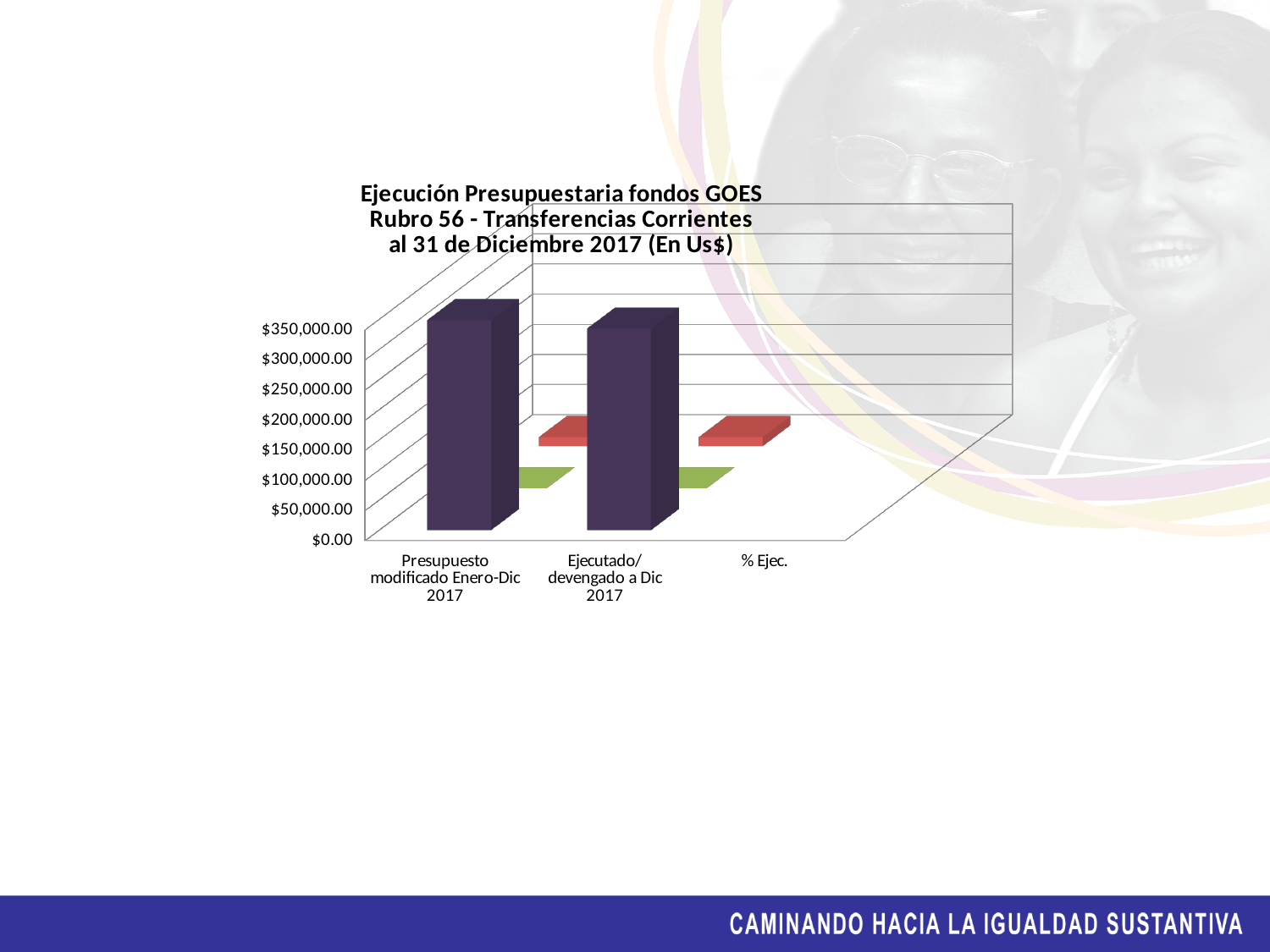
What kind of chart is shown on the slide? bar chart What is the label of the third category on the x axis? % Ejec. How many categories are shown on the x axis of the chart? 3 Which category on the x axis shows the lowest values, with no visible tall bar? % Ejec. What is the title of the chart? Ejecución Presupuestaria fondos GOES Rubro 56 - Transferencias Corrientes al 31 de Diciembre 2017 (En Us$) Is the tall purple bar for 'Ejecutado/devengado a Dic 2017' greater or less than $200,000.00? greater What is the highest value labelled on the vertical axis of the chart? $350,000.00 Is the tall purple bar for 'Presupuesto modificado Enero-Dic 2017' greater or less than $200,000.00? greater Is the tall purple bar for 'Presupuesto modificado Enero-Dic 2017' greater or less than $100,000.00? greater